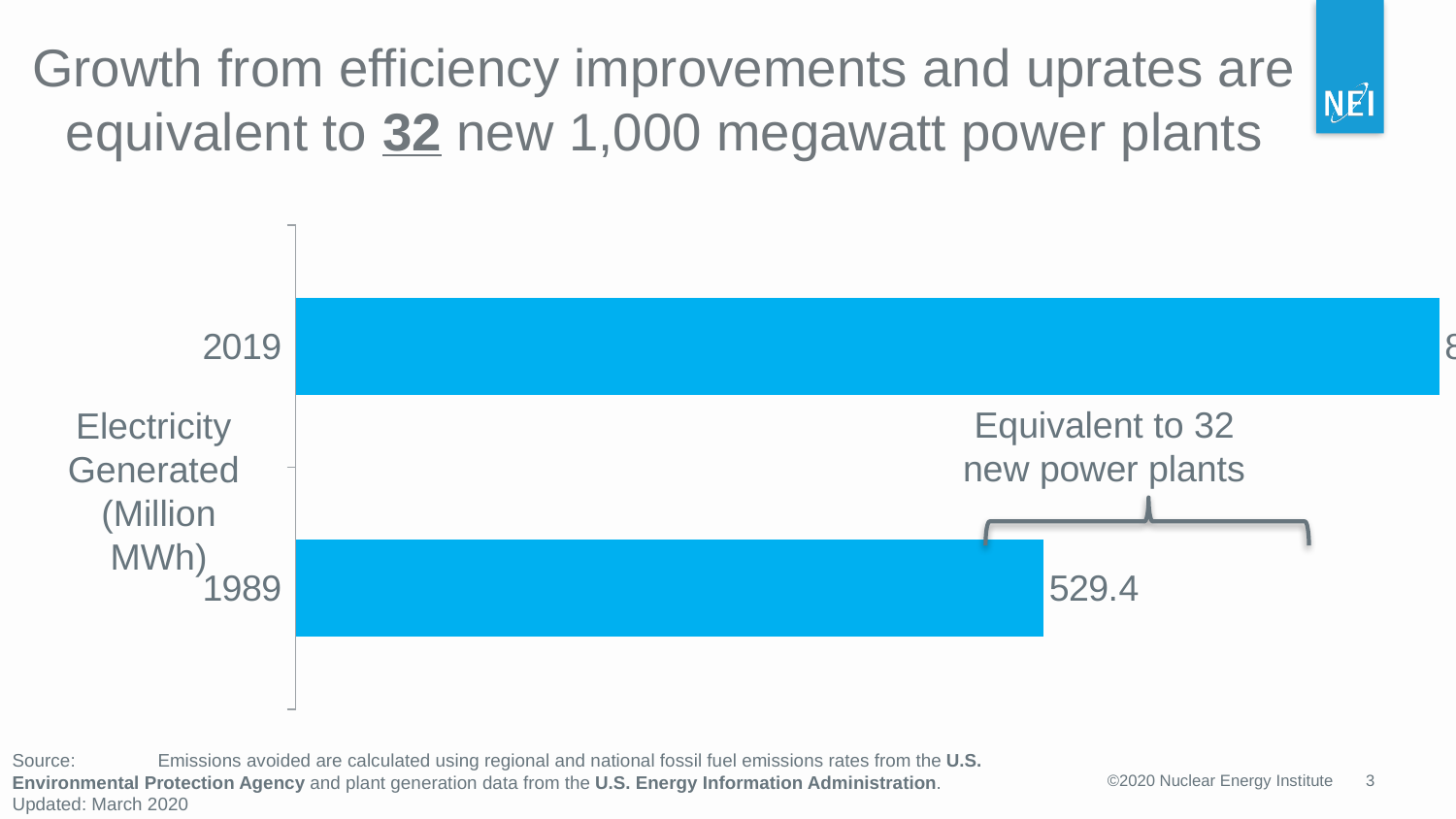
Which year has the shortest bar in the chart? 1989 What unit is the electricity generated measured in, according to the axis label? Million MWh Which year has the longest bar in the chart? 2019 What is the value for 1989 in the Electricity Generated chart? 529.4 How many years (categories) are plotted in the chart? 2 What kind of chart is shown on the slide? Bar chart Which year has the higher electricity generated value, 2019 or 1989? 2019 According to the annotation on the chart, the growth between 1989 and 2019 is equivalent to how many new power plants? 32